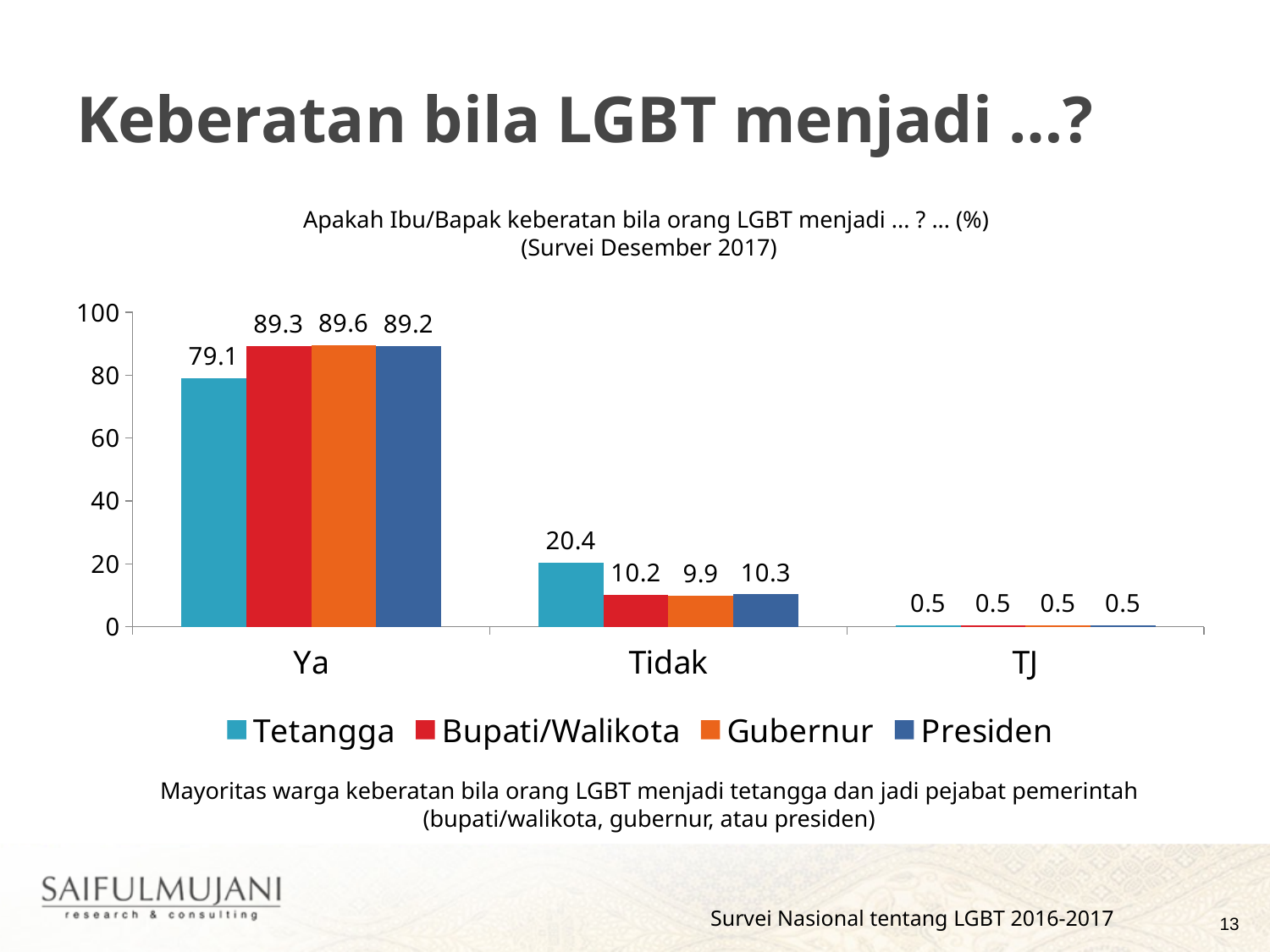
In the Tidak category, which is larger: Tetangga or Gubernur? Tetangga How many series does the legend list? 4 What is the difference between the Tetangga and Presiden values in the Tidak category? 10.1 How many categories are shown on the x axis? 3 Which legend entry is shown in orange? Gubernur What kind of chart is shown on the slide? bar chart What is the difference between the Tetangga and Bupati/Walikota values in the Ya category? 10.2 Which series has the highest value in the Ya category? Gubernur What is the value for Gubernur in the Tidak category? 9.9 Which series has the lowest value in the Ya category? Tetangga What is the value for Tetangga in the Ya category? 79.1 What is the value for Presiden in the TJ category? 0.5